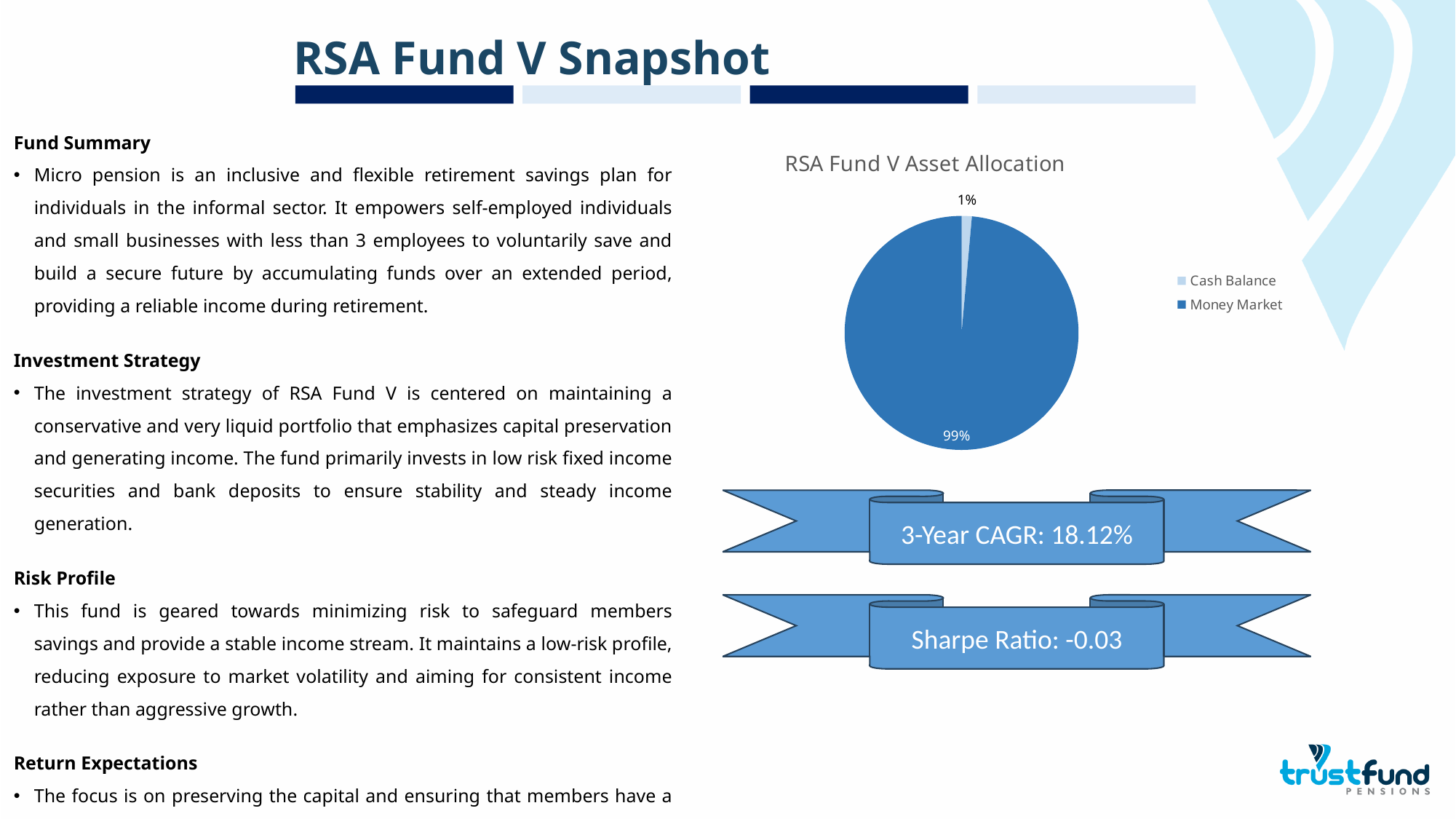
Which legend entry is shown in the darker blue colour? Money Market Which category has the largest slice of the pie? Money Market How many entries does the legend list? 2 What share of the pie does Money Market represent? 99% Which is larger, the Cash Balance slice or the Money Market slice? Money Market What share of the pie does Cash Balance represent? 1% What kind of chart is shown on the slide? pie chart What is the title of the chart? RSA Fund V Asset Allocation Which category has the smallest slice of the pie? Cash Balance What is the difference between the Money Market share and the Cash Balance share? 98% How many categories does the pie chart show? 2